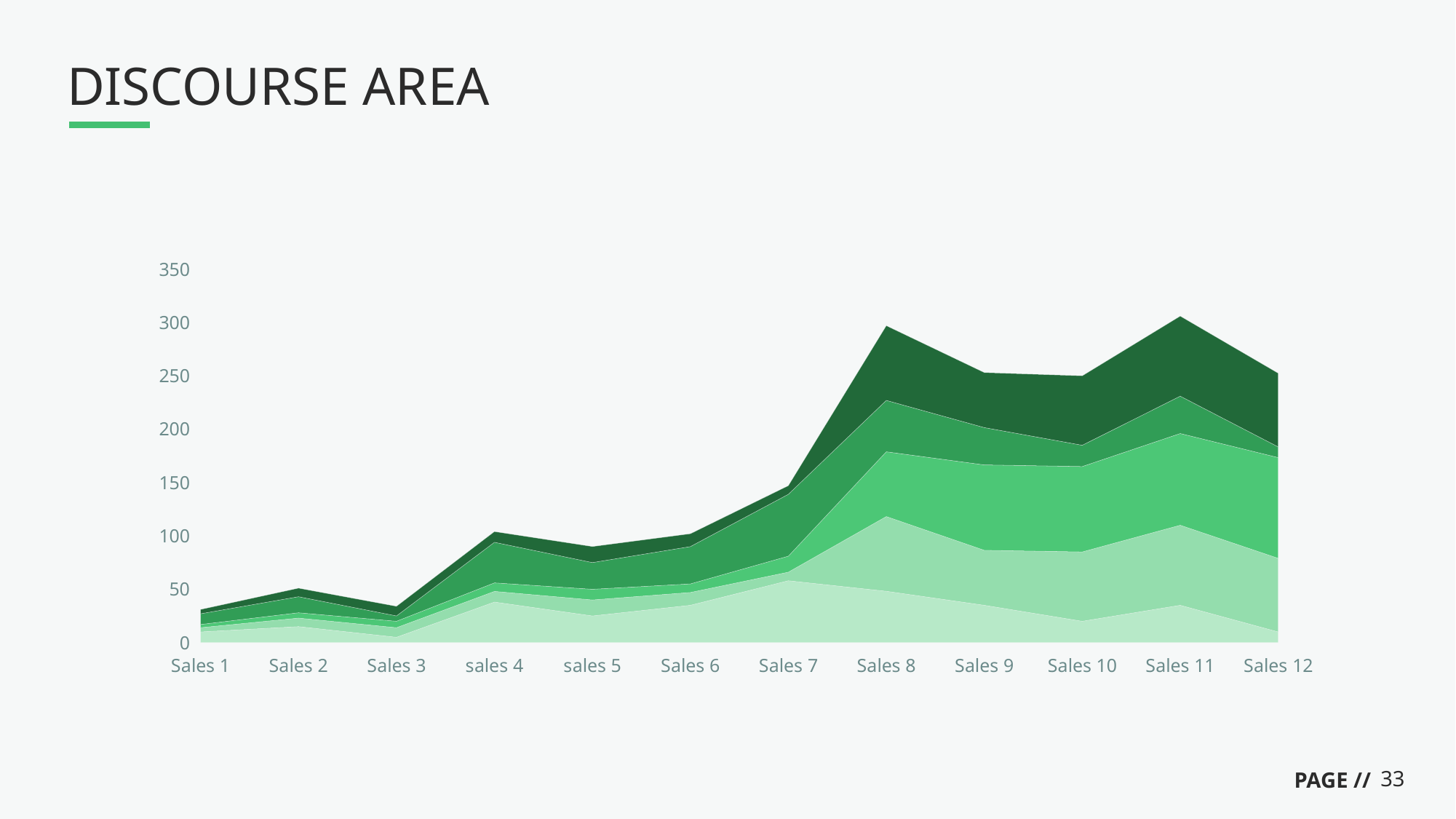
Is the stacked total for Sales 12 greater or less than 200? greater Is the stacked total for Sales 1 greater or less than 50? less Which has the larger stacked total, Sales 8 or Sales 3? Sales 8 What kind of chart is shown on the slide? Stacked area chart What is the highest value shown on the y axis of the chart? 350 Do the stacked totals generally rise or fall from Sales 1 to Sales 11? rise Is the stacked total for Sales 8 greater or less than 250? greater Which has the larger stacked total, Sales 6 or Sales 2? Sales 6 How many categories are shown along the x axis of the chart? 12